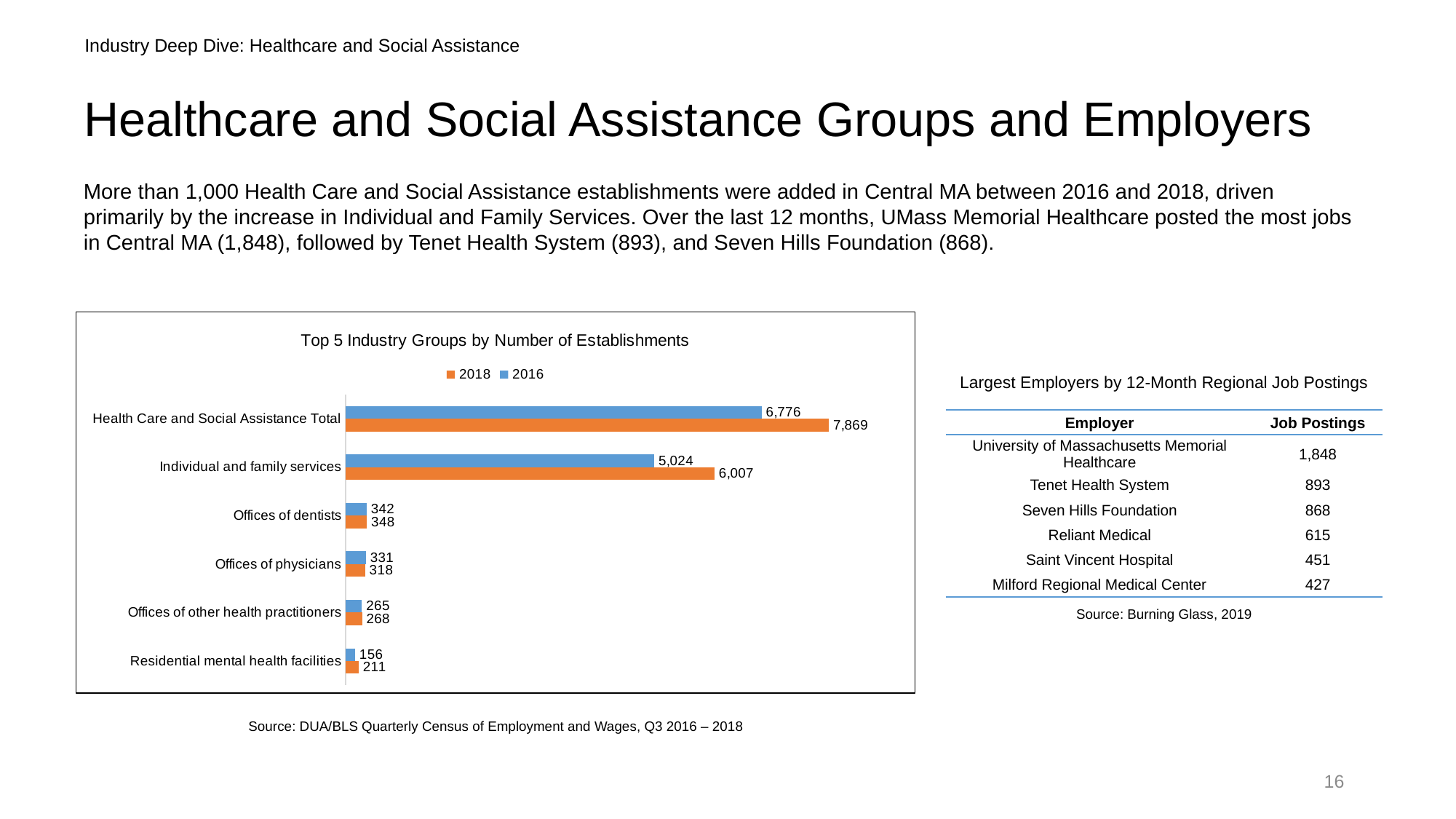
Which category has the lowest 2018 value in the chart? Residential mental health facilities For Offices of physicians, which year has the larger value, 2016 or 2018? 2016 Which category has the highest 2016 value in the chart? Health Care and Social Assistance Total What is the difference between the 2018 and 2016 values for Health Care and Social Assistance Total? 1,093 What is the 2016 value for Residential mental health facilities in the chart? 156 How many categories are shown on the y axis of the chart? 6 How many series does the chart's legend list? 2 What is the difference between the 2018 and 2016 values for Residential mental health facilities? 55 What is the 2018 value for Offices of physicians in the chart? 318 What type of chart is used for Top 5 Industry Groups by Number of Establishments? Bar chart What is the 2016 value for Health Care and Social Assistance Total in the chart? 6,776 What is the 2018 value for Individual and family services in the Top 5 Industry Groups by Number of Establishments chart? 6,007